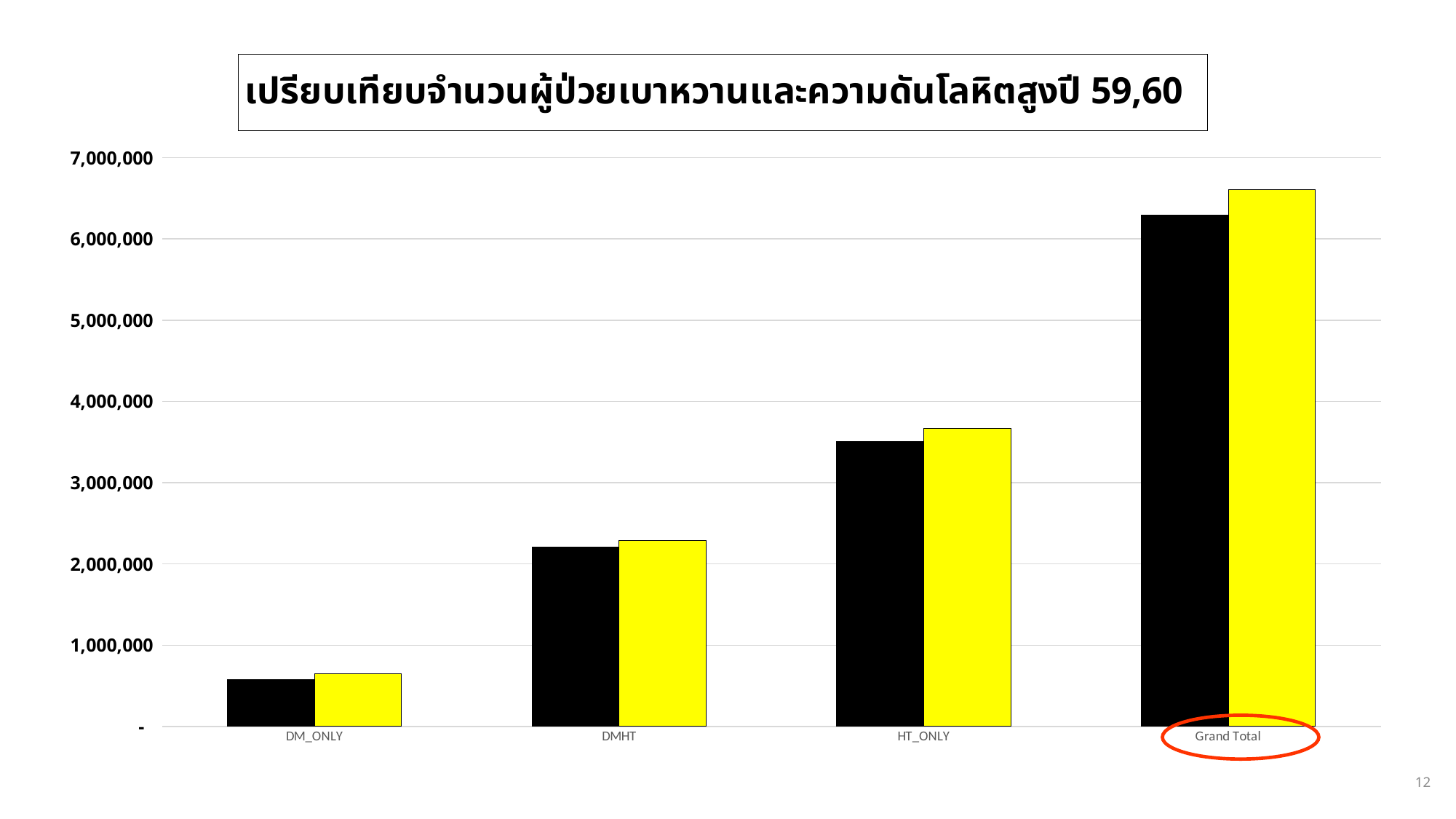
What kind of chart is shown on the slide? bar chart Which category has the shortest bars? DM_ONLY Is the value of the yellow bar for HT_ONLY greater or less than 4,000,000? less Which category has the tallest bars? Grand Total How many categories are shown on the x axis? 4 Do the bar values rise or fall from left to right across the categories? rise Is the value of the yellow bar for DMHT greater or less than 2,000,000? greater Is the value of the black bar for DM_ONLY greater or less than 1,000,000? less Which category label is circled in red on the slide? Grand Total Which is larger, the black bar for HT_ONLY or the black bar for DMHT? HT_ONLY